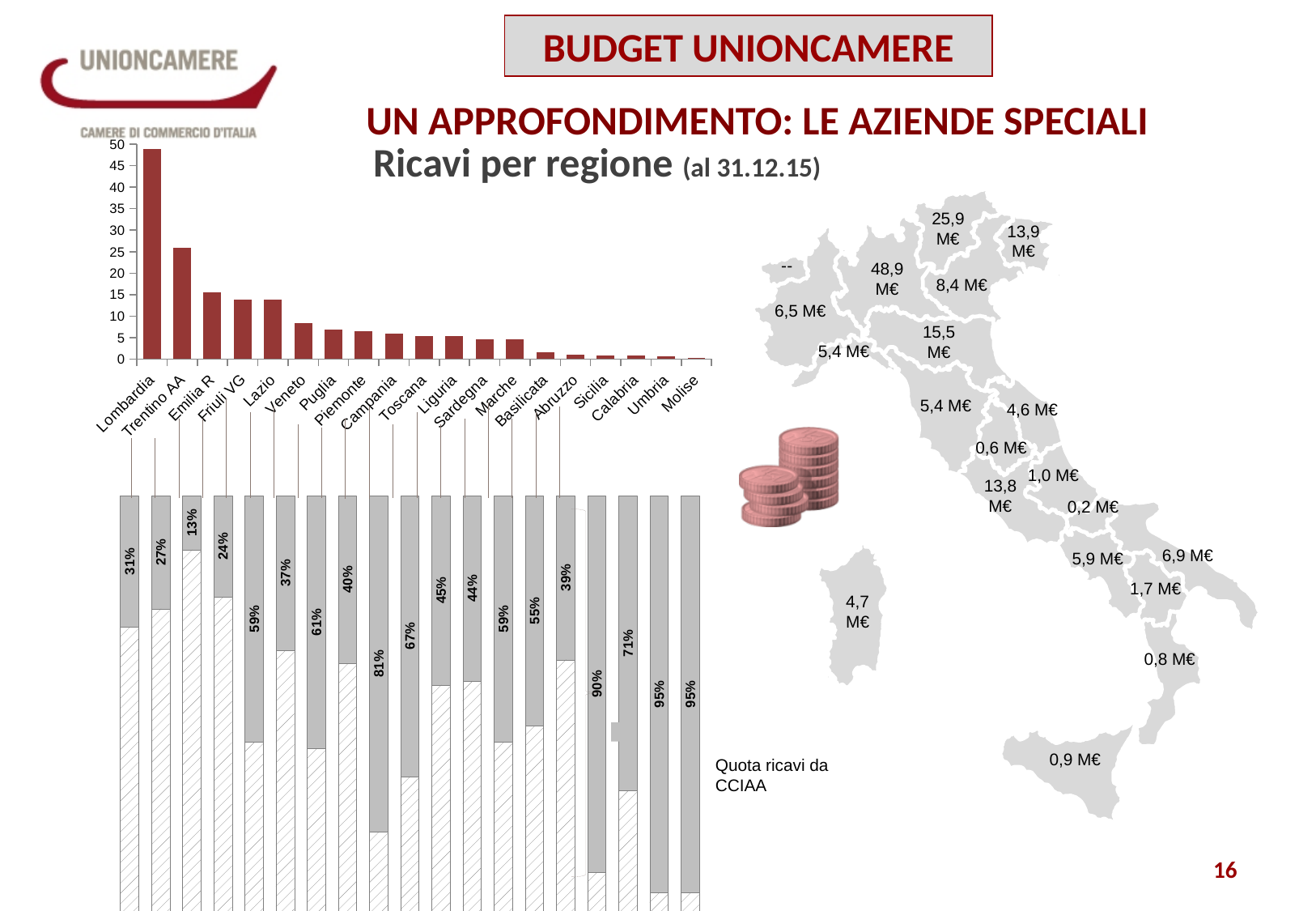
In the 'Ricavi per regione' chart, is the value for Abruzzo greater or less than 5? less In the 'Ricavi per regione' chart, do the values rise or fall from left to right along the x axis? fall In the 'Ricavi per regione' chart, is the value for Lombardia greater or less than 40? greater In the 'Ricavi per regione' chart, which region has the lowest value? Molise In the lower 'Quota ricavi da CCIAA' chart, what is the lowest percentage shown? 13% In the 'Ricavi per regione' chart, which is larger, the value for Lombardia or the value for Trentino AA? Lombardia What date is given in the title of the 'Ricavi per regione' chart? al 31.12.15 In the 'Ricavi per regione' chart, is the value for Trentino AA greater or less than 30? less In the 'Ricavi per regione' chart, which region has the highest value? Lombardia What type of chart is the 'Ricavi per regione' chart? bar chart How many regions are shown in the 'Ricavi per regione' bar chart? 19